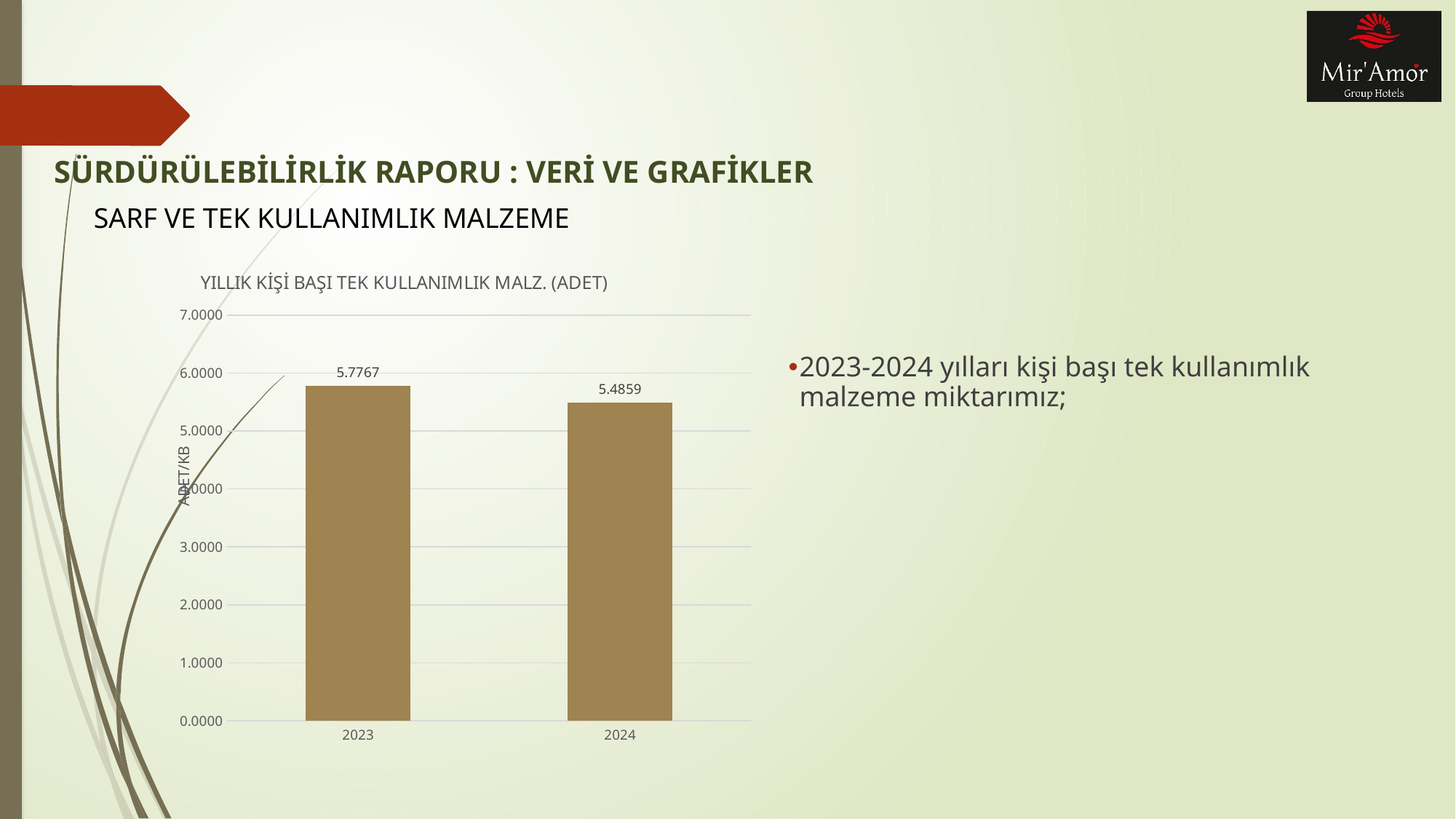
What is the difference between the values for 2023 and 2024? 0.2908 Do the values rise or fall from 2023 to 2024? fall What kind of chart is shown on the slide? bar chart Which year has the highest value? 2023 What is the value for 2024? 5.4859 Which is larger, the value for 2023 or the value for 2024? 2023 Is the value for 2023 greater or less than 6.0000? less Which year has the lowest value? 2024 What is the value for 2023? 5.7767 How many years are shown on the chart? 2 What is the title of the chart? YILLIK KİŞİ BAŞI TEK KULLANIMLIK MALZ. (ADET) Is the value for 2024 greater or less than 5.0000? greater